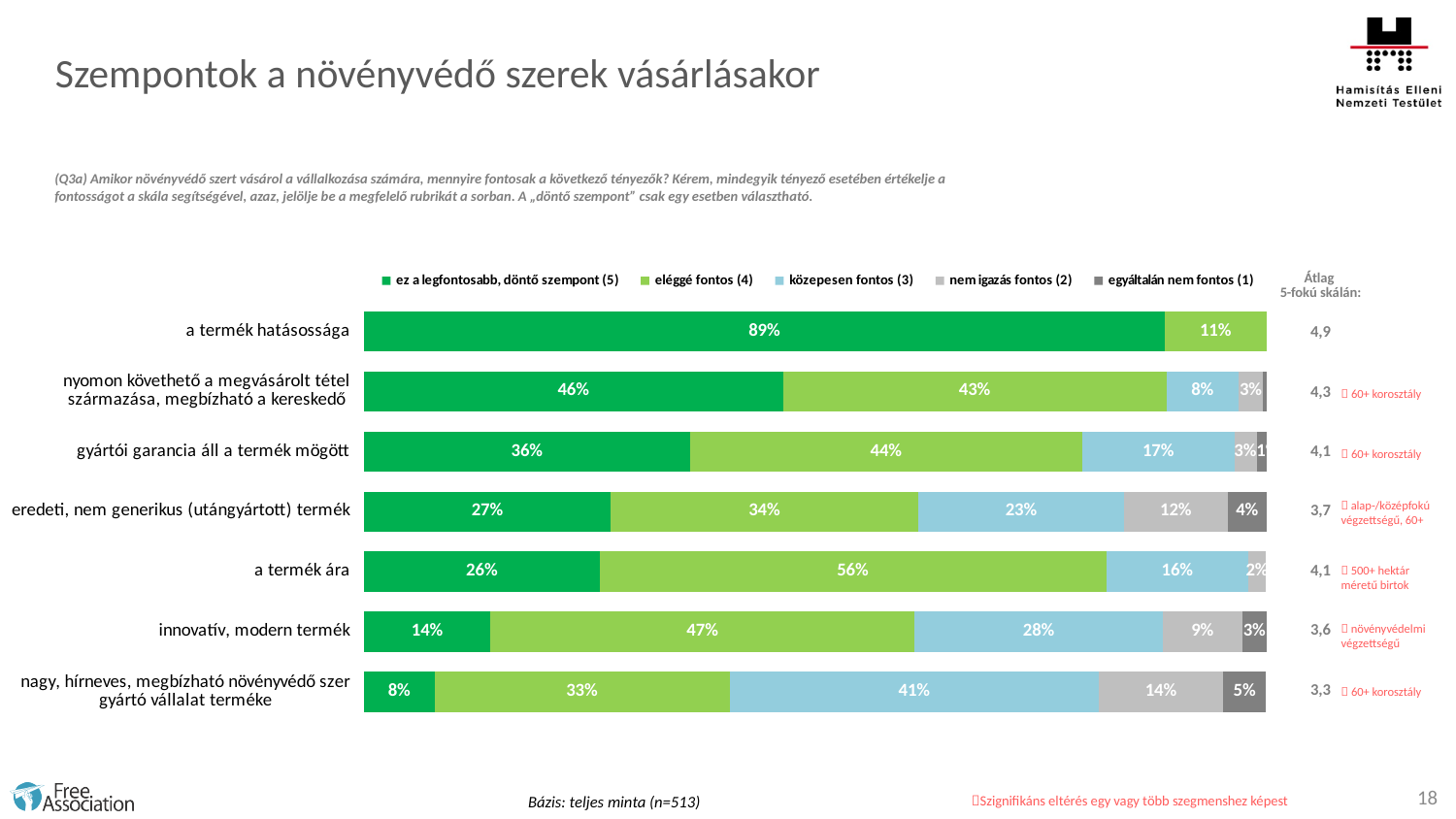
What percentage of respondents rated "a termék hatásossága" as "ez a legfontosabb, döntő szempont (5)"? 89% What is the "eléggé fontos (4)" share for "a termék ára"? 56% How many categories (factors) are shown in the chart? 7 How many percentage points higher is the "ez a legfontosabb, döntő szempont (5)" share for "nyomon követhető a megvásárolt tétel származása, megbízható a kereskedő" than for "gyártói garancia áll a termék mögött"? 10 percentage points What is the average score on the 5-point scale (Átlag) shown for "a termék hatásossága"? 4,9 Which category has the highest "ez a legfontosabb, döntő szempont (5)" share? a termék hatásossága What kind of chart is shown on the slide? Stacked bar chart Which has the larger "közepesen fontos (3)" share: "innovatív, modern termék" or "nagy, hírneves, megbízható növényvédő szer gyártó vállalat terméke"? nagy, hírneves, megbízható növényvédő szer gyártó vállalat terméke Which category has the lowest "ez a legfontosabb, döntő szempont (5)" share? nagy, hírneves, megbízható növényvédő szer gyártó vállalat terméke What is the "közepesen fontos (3)" share for "eredeti, nem generikus (utángyártott) termék"? 23% How many series does the legend list? 5 What is the "egyáltalán nem fontos (1)" share for "nagy, hírneves, megbízható növényvédő szer gyártó vállalat terméke"? 5%